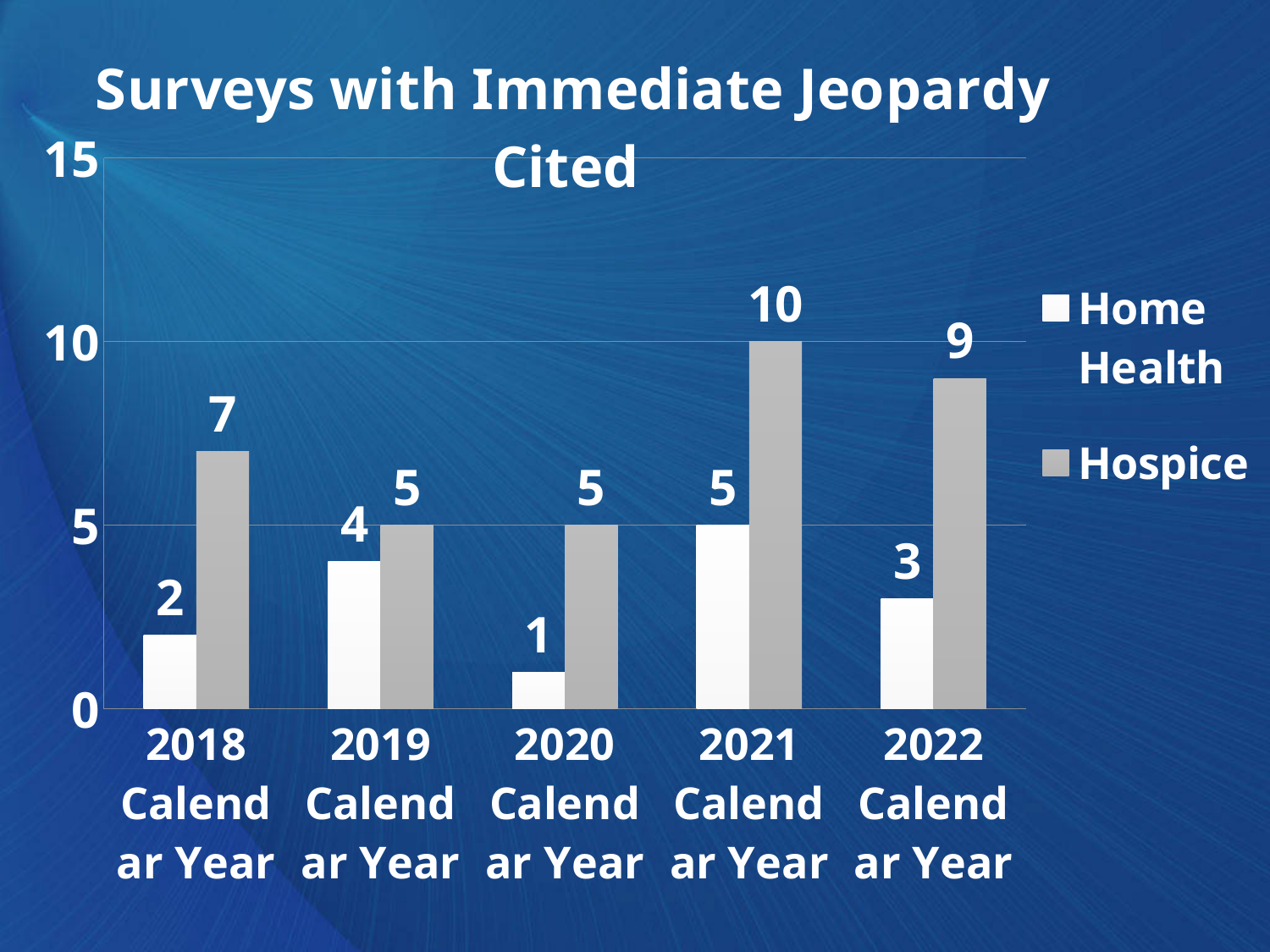
What is the Home Health value for 2020 Calendar Year? 1 How many series does the legend list? 2 Which calendar year has the lowest Home Health value? 2020 Calendar Year What is the Home Health value for 2018 Calendar Year? 2 What is the title of the chart? Surveys with Immediate Jeopardy Cited What kind of chart is shown on the slide? bar chart What is the difference between the Hospice and Home Health values for 2022 Calendar Year? 6 Is the Hospice value for 2018 Calendar Year greater or less than 5? greater What is the Hospice value for 2021 Calendar Year? 10 How many calendar years are shown on the x axis? 5 Which calendar year has the highest Hospice value? 2021 Calendar Year Which is larger in 2019 Calendar Year, Home Health or Hospice? Hospice